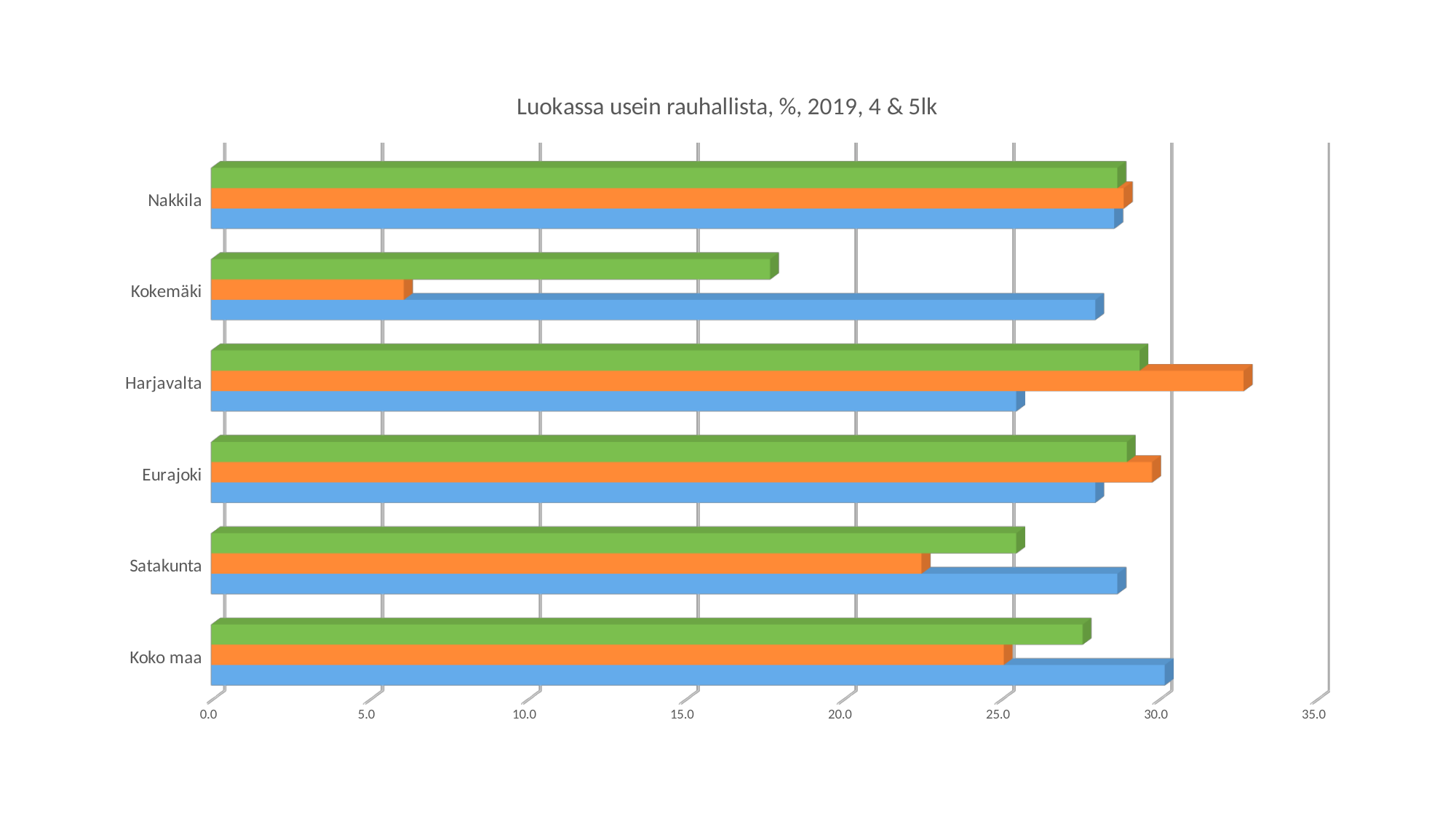
Is the value of the orange bar for Kokemäki greater or less than 10.0? less What kind of chart is shown on the slide? bar chart For Kokemäki, which bar is larger, the blue bar or the orange bar? blue bar How many bars are plotted for each category in the chart? 3 Is the value of the orange bar for Satakunta greater or less than 25.0? less What is the title of the chart? Luokassa usein rauhallista, %, 2019, 4 & 5lk Is the value of the green bar for Kokemäki greater or less than 20.0? less For Satakunta, which bar is larger, the green bar or the orange bar? green bar Which category has the lowest value among the orange bars? Kokemäki How many categories are shown on the vertical axis of the chart? 6 Which category has the highest value among the orange bars? Harjavalta